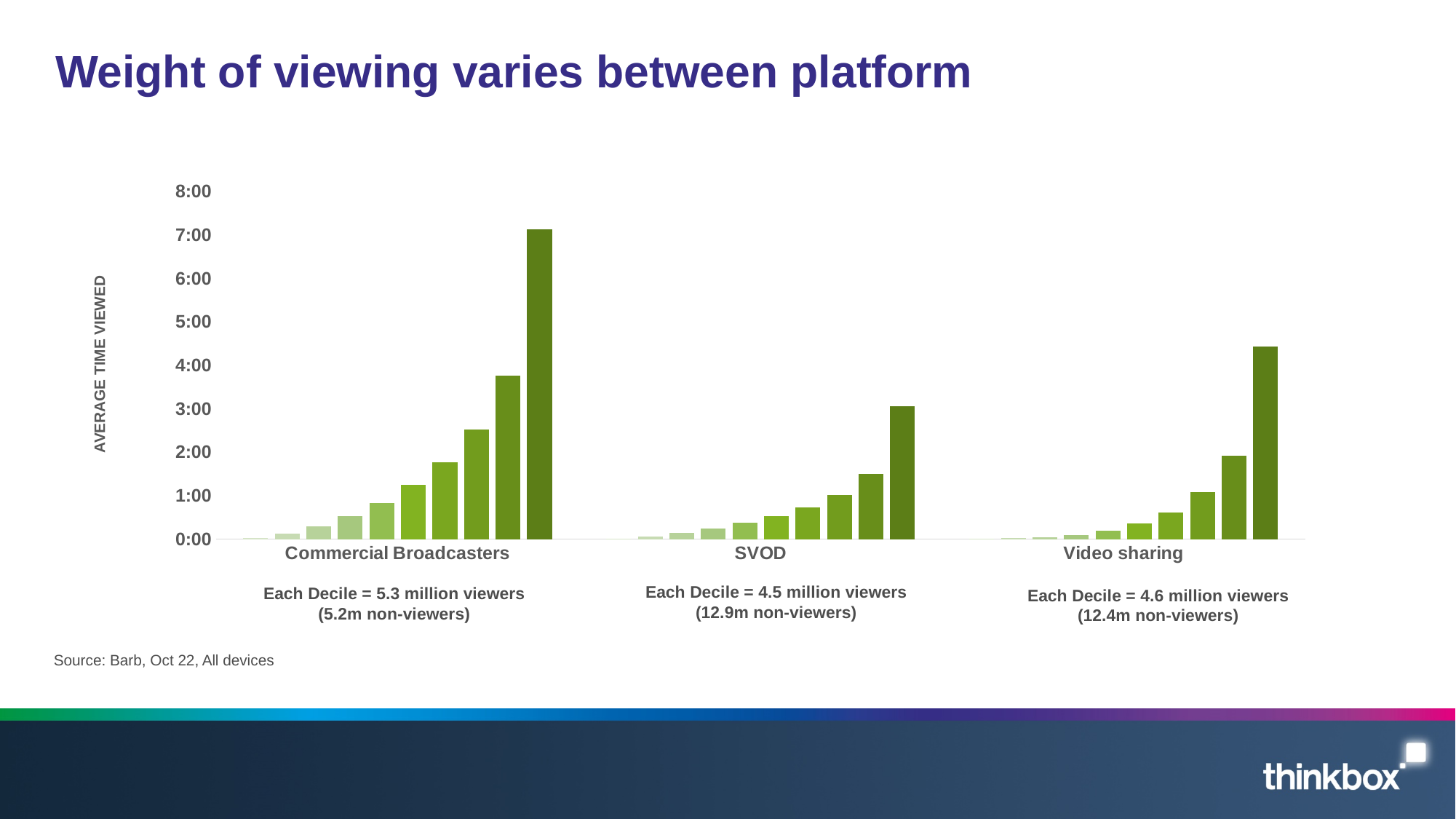
How many bars are plotted for the Commercial Broadcasters group? 10 According to the note under the chart, how many viewers does each decile represent for Commercial Broadcasters? 5.3 million viewers What is the label on the vertical axis of the chart? AVERAGE TIME VIEWED What kind of chart is shown on the slide? Bar chart Is the tallest bar for Commercial Broadcasters greater or less than 6:00? greater Which platform group has the lowest tallest bar in the chart? SVOD How many platform groups are shown along the x axis of the chart? 3 Which platform group has the tallest bar in the chart? Commercial Broadcasters Within each platform group, do the bars rise or fall from left to right? Rise Is the tallest bar for Video sharing greater or less than 5:00? less Is the tallest bar for SVOD greater or less than 2:00? greater Which is larger: the tallest bar for SVOD or the tallest bar for Video sharing? Video sharing